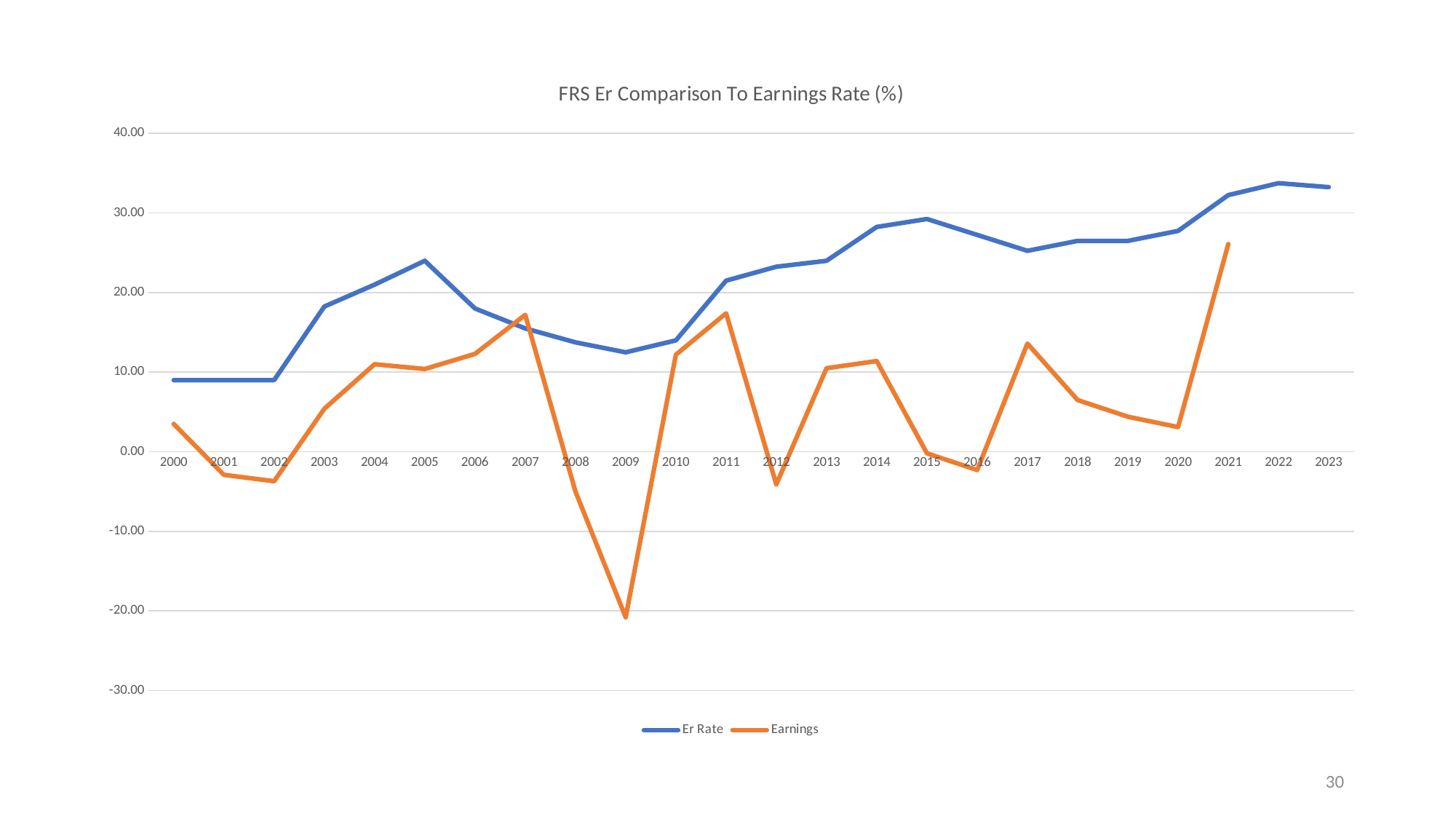
What is the title of the chart? FRS Er Comparison To Earnings Rate (%) How many years are shown on the x axis? 24 Which colour is used for the Earnings series? orange How many series does the legend list? 2 What kind of chart is shown on the slide? line chart Is the Er Rate value for 2005 greater or less than 20.00? greater Is the Er Rate value for 2023 greater or less than 30.00? greater Does the Er Rate series overall rise or fall from 2000 to 2023? rise In 2009, which series has the larger value, Er Rate or Earnings? Er Rate Is the Earnings value for 2009 greater or less than -10.00? less In which year is the Earnings series at its lowest? 2009 In which year is the Earnings series at its highest? 2021